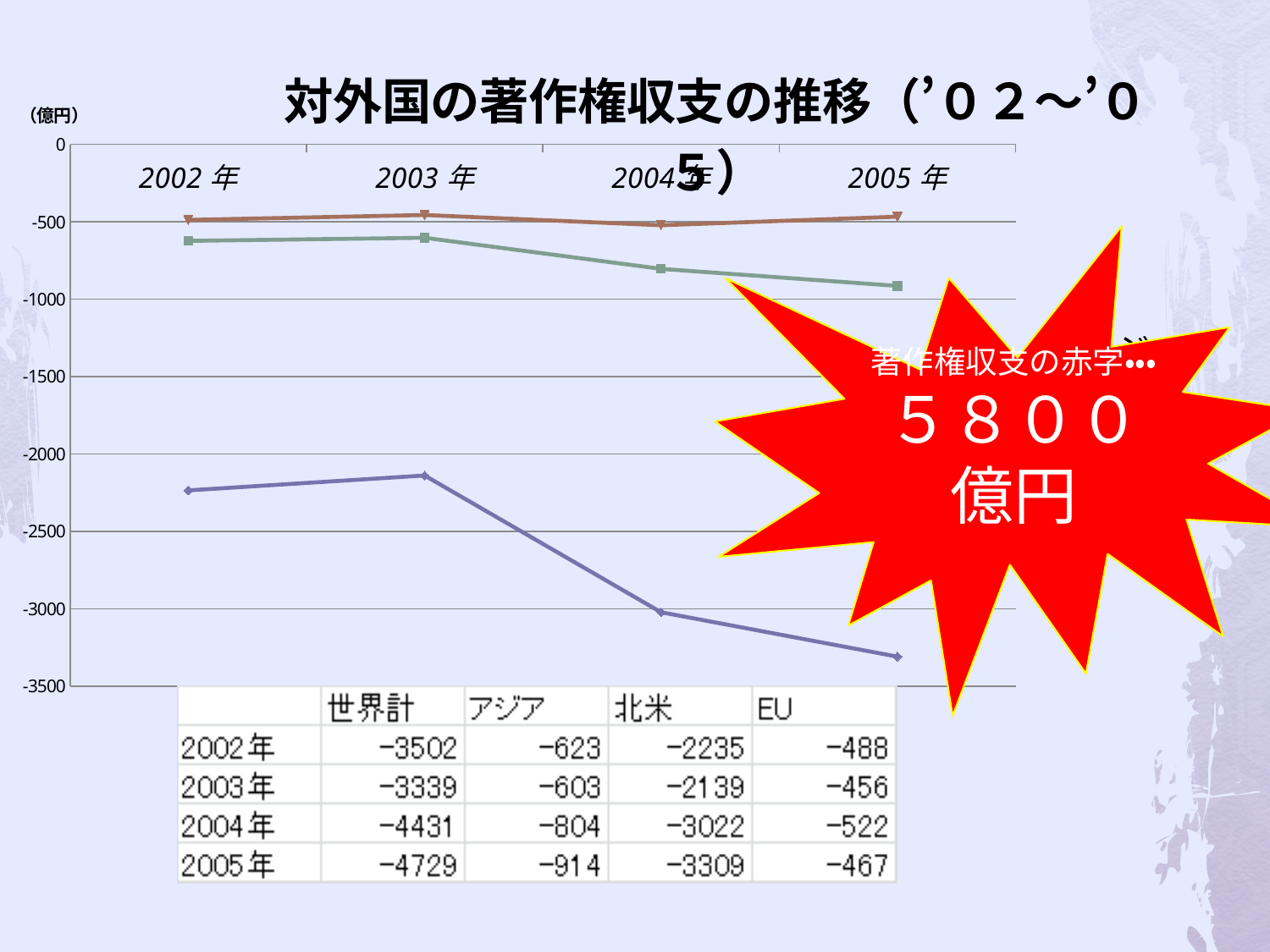
What kind of chart is shown on the slide? line chart By how much did the 北米 value change between 2002年 and 2005年? 1074 Which is larger in 2004年, the アジア value or the EU value? EU What is the アジア value for 2005年? -914 In which year is the EU value highest (closest to zero)? 2003年 In which year is the 北米 value lowest? 2005年 What unit is shown at the top of the y axis? 億円 What is the EU value for 2003年? -456 What is the 北米 value for 2004年 in the table below the chart? -3022 Does the 北米 line rise or fall overall from 2002年 to 2005年? fall How many years are plotted along the x axis of the chart? 4 What is the 世界計 value for 2002年? -3502